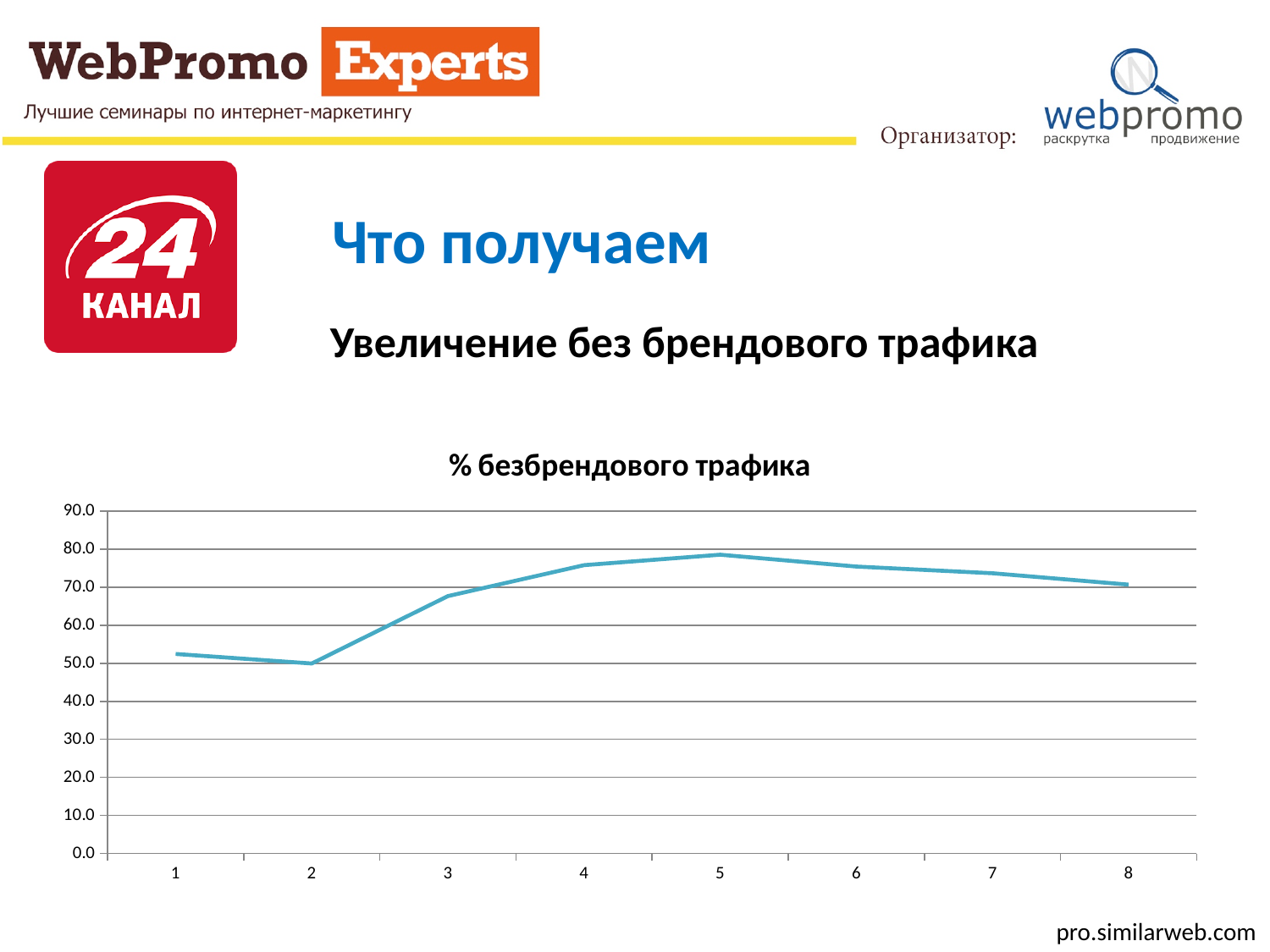
At which x-axis point does the line reach its highest value? 5 Is the value at point 4 greater or less than 80.0? less Which has the larger value, point 5 or point 8? 5 Which has the larger value, point 2 or point 3? 3 What is the title of the chart? % безбрендового трафика How many points are plotted along the x axis of the chart? 8 Does the line rise or fall between point 5 and point 8? fall Is the value at point 3 greater or less than 60.0? greater Is the value at point 2 greater or less than 60.0? less What kind of chart is shown on the slide? line chart At which x-axis point does the line reach its lowest value? 2